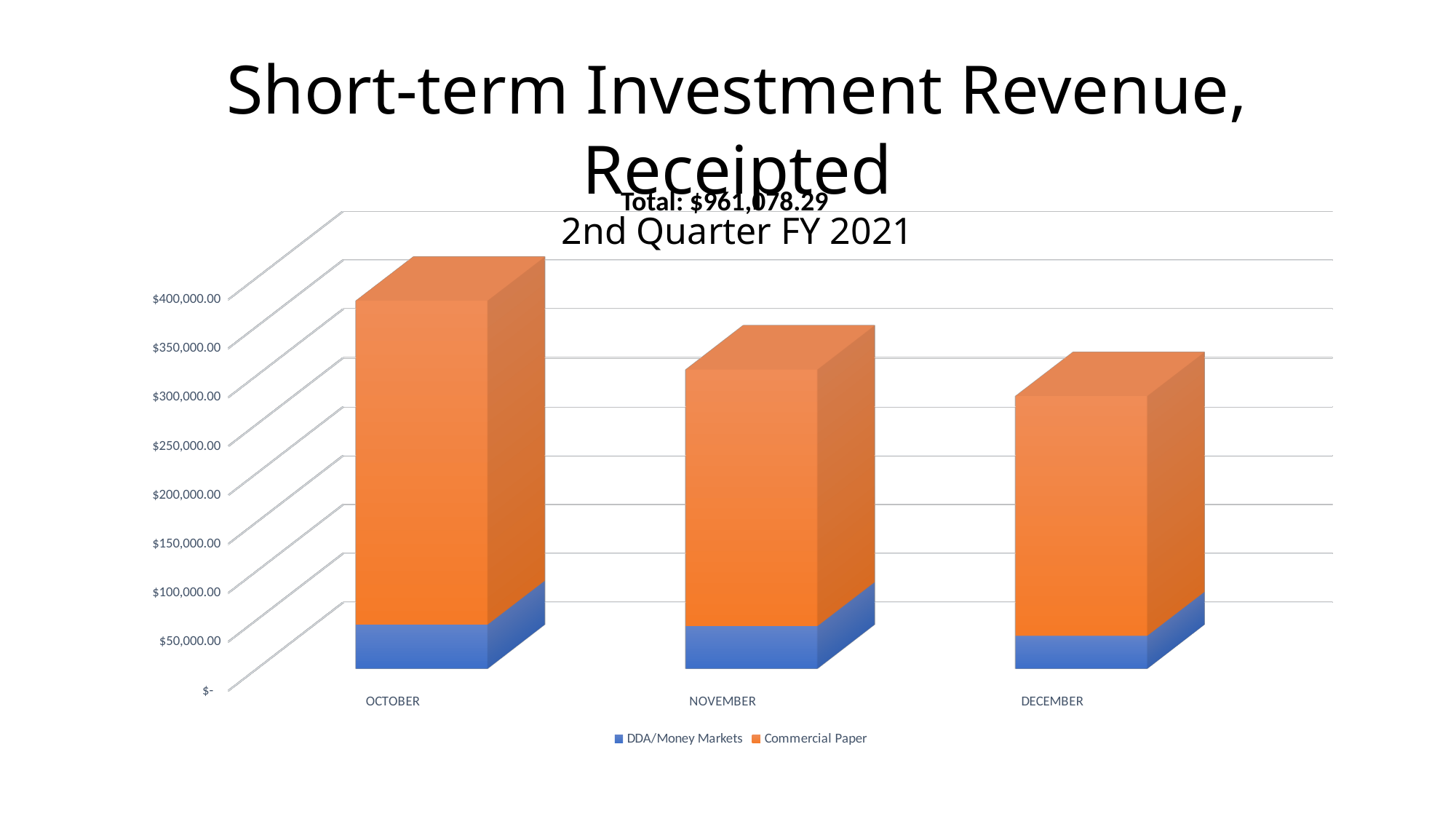
Is the total bar for October greater or less than $350,000.00? greater What total amount is printed above the chart? $961,078.29 How many series does the chart legend list? 2 Is the DDA/Money Markets segment for October greater or less than $100,000.00? less Is the total bar for November greater or less than $350,000.00? less What kind of chart is shown on the slide? bar chart Do the total bar heights rise or fall from October to December? fall Which month has the lowest total bar? December How many months are shown on the x axis of the chart? 3 Which month has a larger total bar, October or November? October Which month has the highest total bar? October